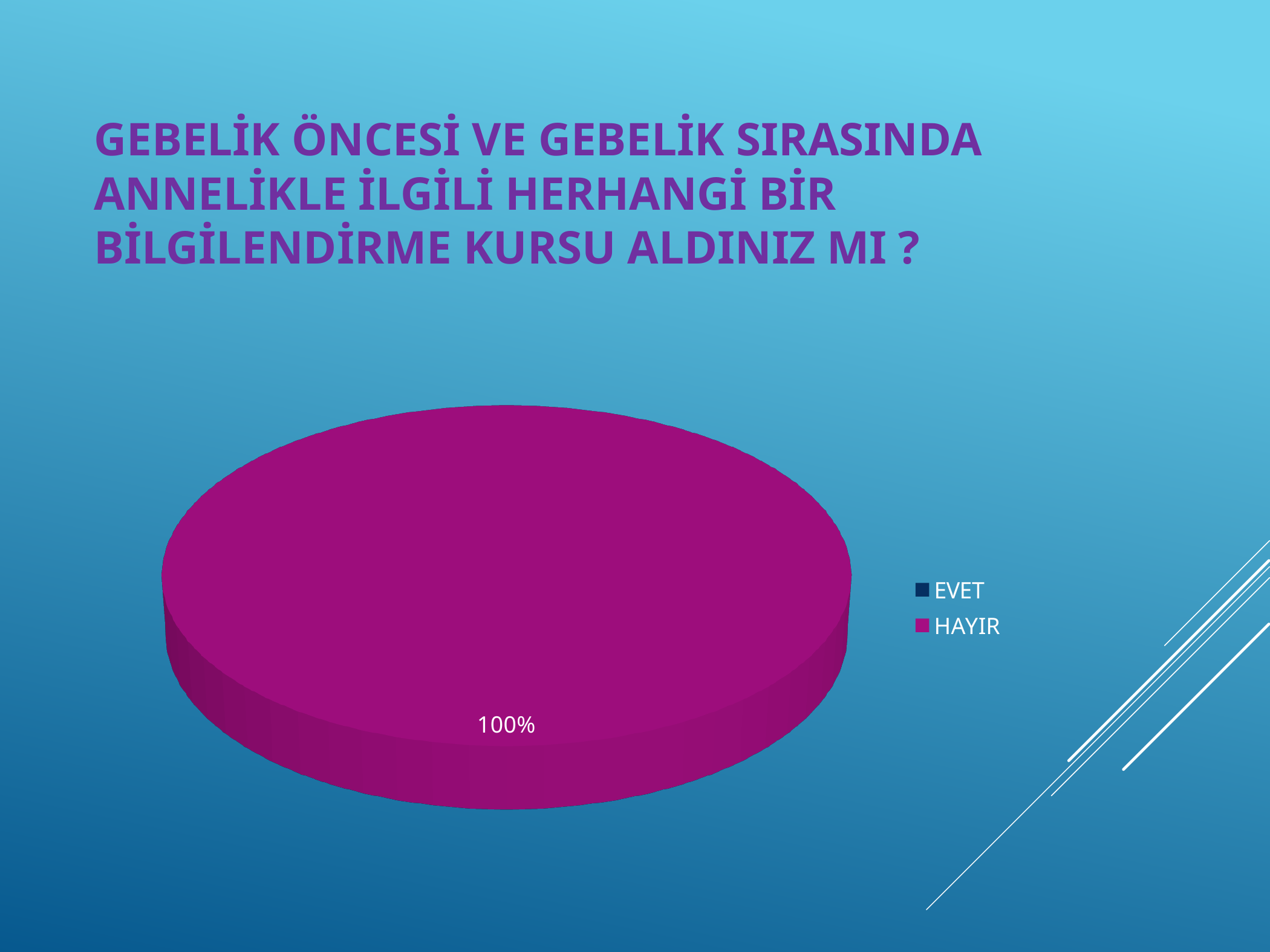
Which is larger, the share for EVET or the share for HAYIR? HAYIR What is the only percentage label printed on the pie? 100% What share of the pie does HAYIR take? 100% How many entries does the legend list? 2 Which category has the largest share of the pie? HAYIR Which legend entry is shown in dark blue? EVET Which category has the smallest share of the pie? EVET What kind of chart is shown on the slide? pie chart What colour is the HAYIR slice in the legend? magenta